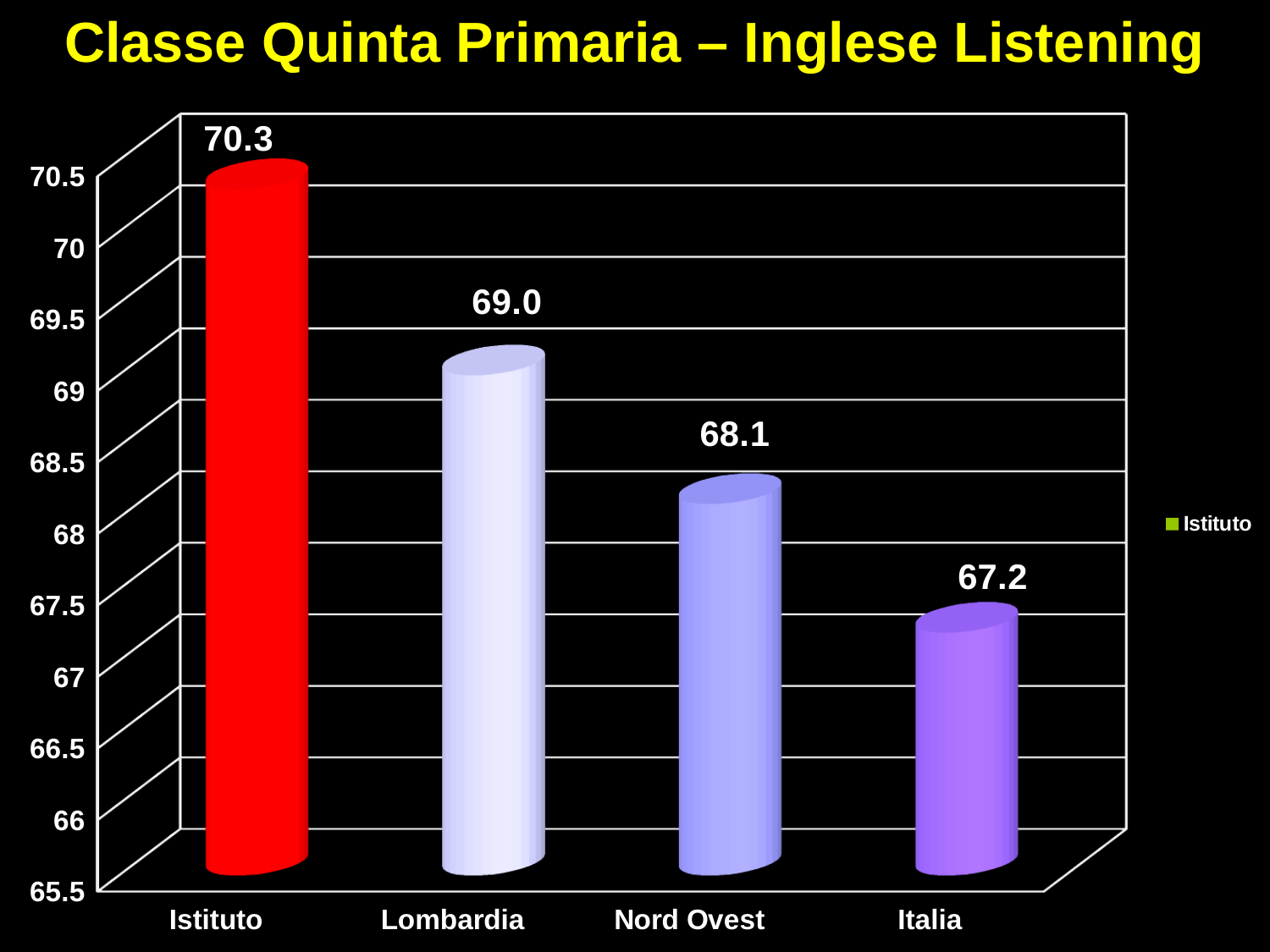
What is the value for Istituto? 70.3 Do the values rise or fall from left to right along the x axis? Fall Which category has the lowest value? Italia What is the difference between the values for Istituto and Italia? 3.1 What is the value for Nord Ovest? 68.1 What kind of chart is shown on the slide? Bar chart Which category has the highest value? Istituto Which is larger, the value for Lombardia or the value for Nord Ovest? Lombardia What is the value for Italia? 67.2 What is the value for Lombardia? 69.0 What is the difference between the values for Lombardia and Nord Ovest? 0.9 How many categories are shown on the x axis? 4